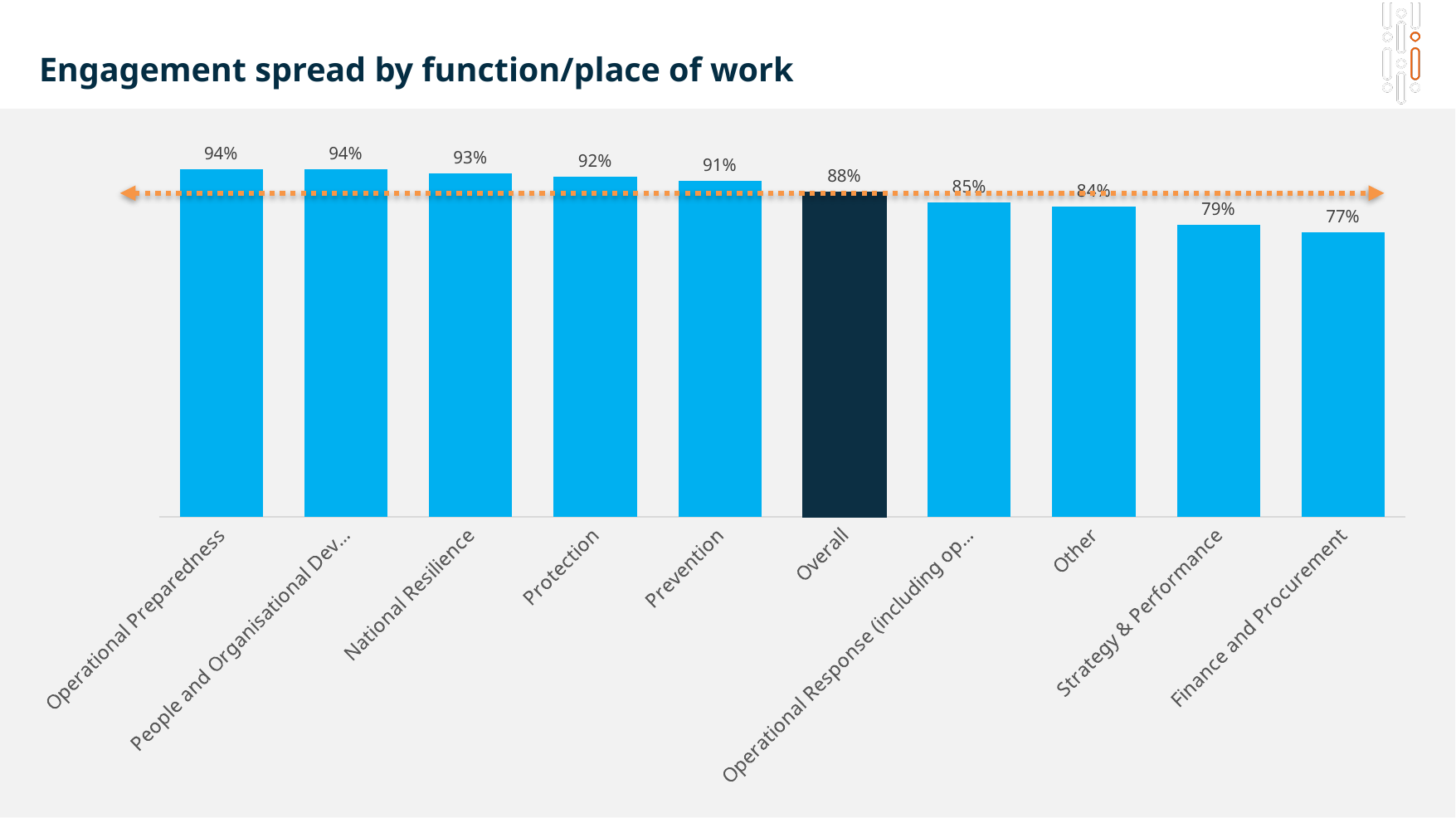
Which is larger, Prevention or Other? Prevention Which category has the lowest value? Finance and Procurement How many bars are shown in the chart? 10 What is the difference between Protection and Other? 8% What kind of chart is shown on the slide? Bar chart What is the difference between Overall and Finance and Procurement? 11% Do the values rise or fall from left to right along the x axis? Fall What is the value for National Resilience? 93% Which bar is coloured dark navy rather than light blue? Overall What is the value for Overall? 88% What is the value for Finance and Procurement? 77% What is the value for Strategy & Performance? 79%